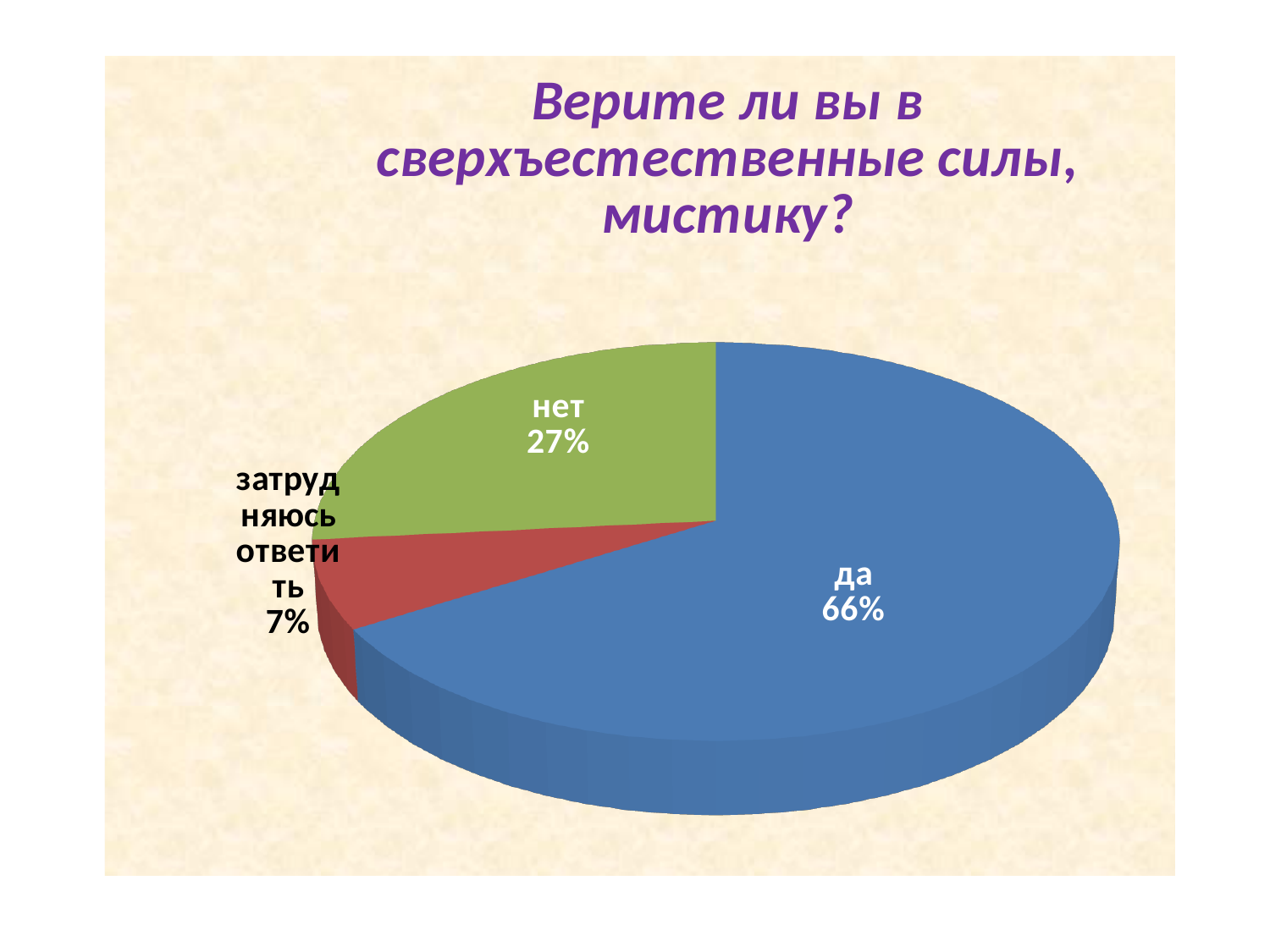
What share of the pie does the "нет" slice represent? 27% What is the difference in percentage points between the "нет" and "затрудняюсь ответить" slices? 20 What colour is the "да" slice? blue Which category has the largest slice of the pie? да How many categories are shown in the pie chart? 3 Which category has the smallest slice of the pie? затрудняюсь ответить What is the difference in percentage points between the "да" and "нет" slices? 39 What is the title of the chart? Верите ли вы в сверхъестественные силы, мистику? What kind of chart is shown on the slide? pie chart What share of the pie does the "затрудняюсь ответить" slice represent? 7% What share of the pie does the "да" slice represent? 66% Which is larger, the "нет" slice or the "затрудняюсь ответить" slice? нет